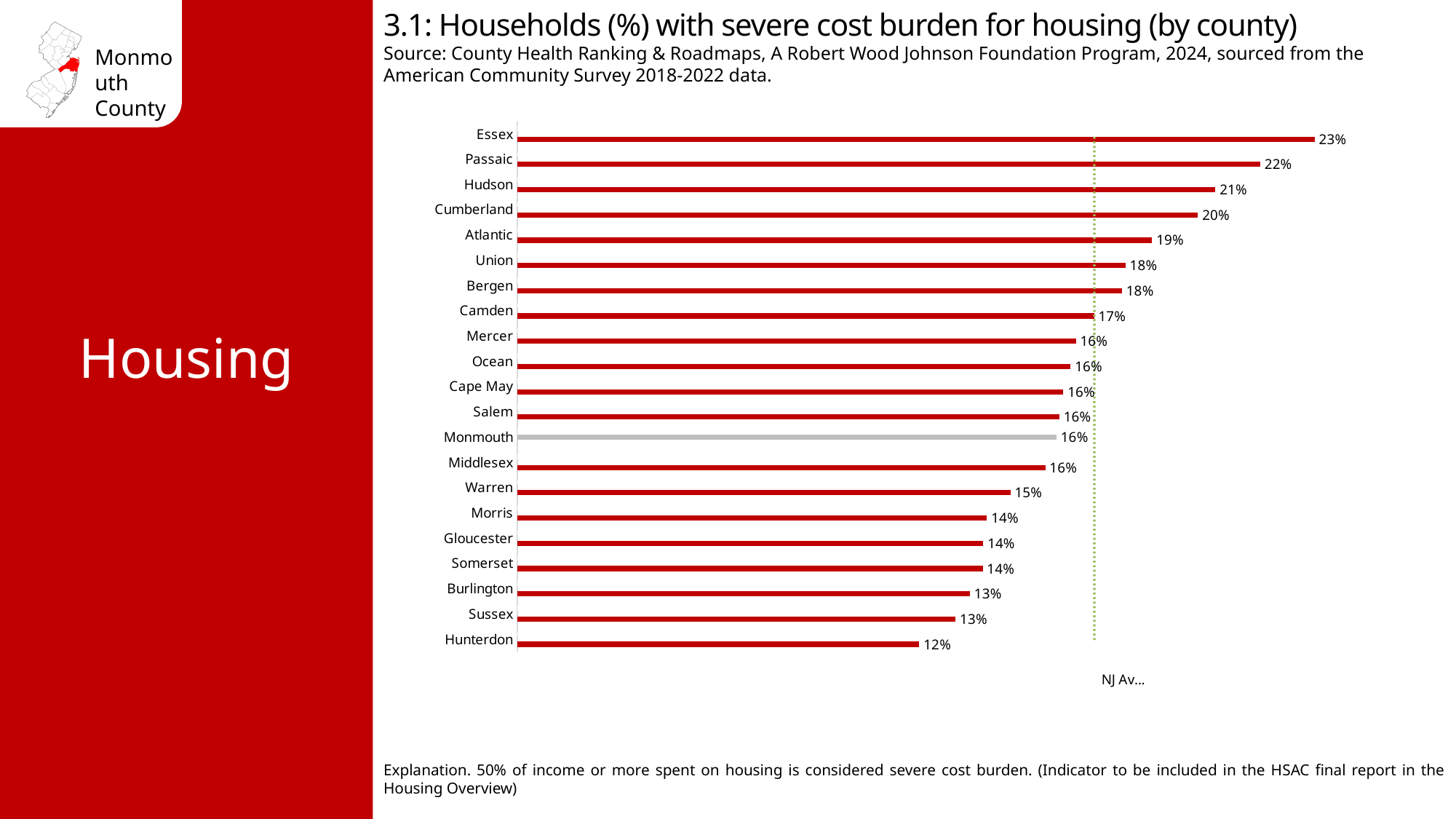
What is the value for Cumberland? 20% How many counties are shown in the chart? 21 What kind of chart is shown on the slide? Bar chart What is the difference between the values for Essex and Hunterdon? 11% What is the value for Monmouth? 16% Which county has the highest percentage of households with severe cost burden for housing? Essex What is the value for Essex? 23% Which county has the lowest percentage of households with severe cost burden for housing? Hunterdon Which is larger, the value for Hudson or the value for Atlantic? Hudson What is the difference between the values for Passaic and Warren? 7% What is the value for Hunterdon? 12% Which county's bar is shown in grey rather than red? Monmouth